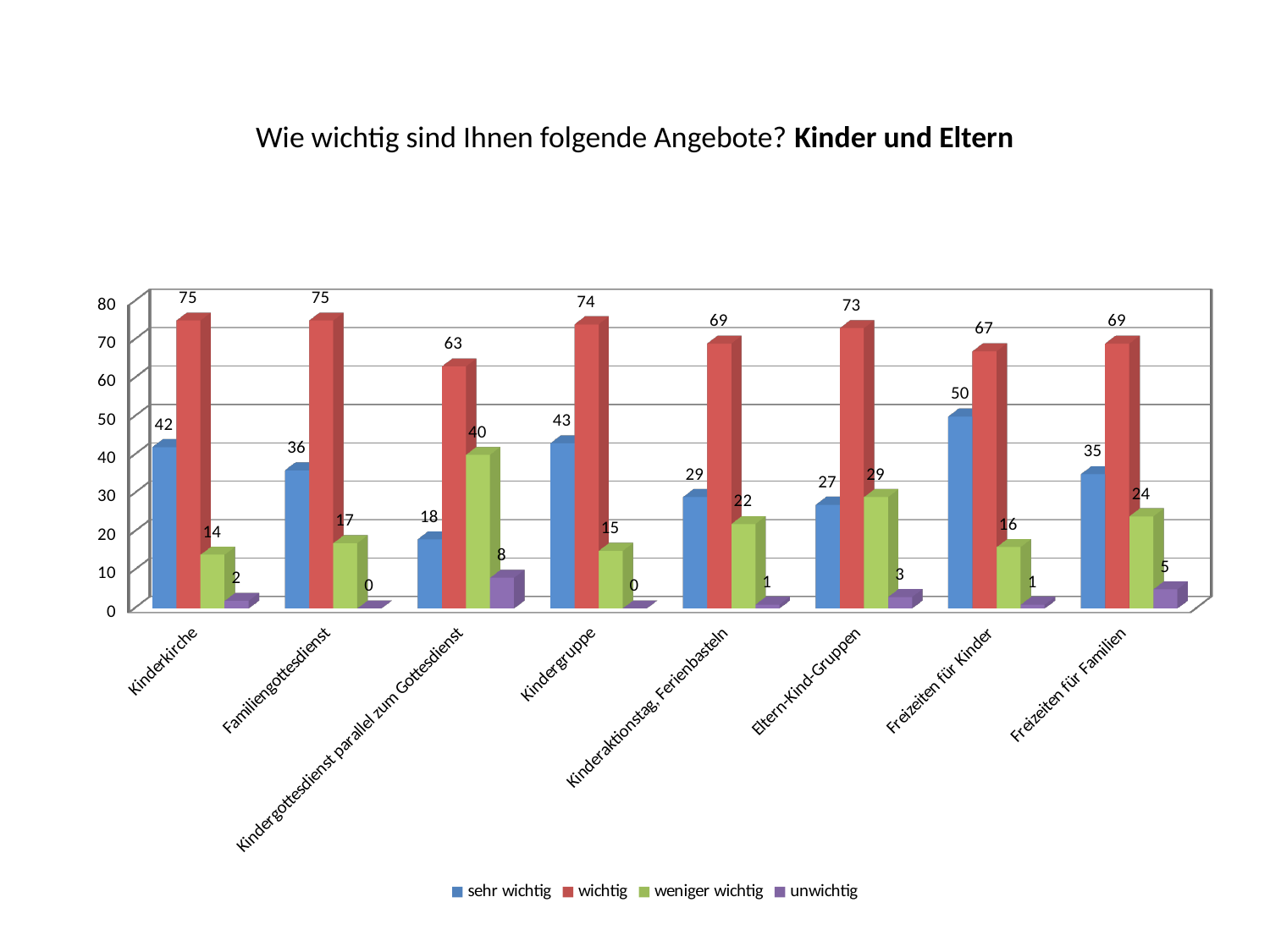
Which category has the highest value for "unwichtig"? Kindergottesdienst parallel zum Gottesdienst What is the value for "weniger wichtig" for Kindergottesdienst parallel zum Gottesdienst? 40 Which category has the lowest value for "wichtig"? Kindergottesdienst parallel zum Gottesdienst What is the value for "wichtig" for Eltern-Kind-Gruppen? 73 What is the value for "sehr wichtig" for Freizeiten für Kinder? 50 How many series does the legend list? 4 How many categories are shown on the x axis? 8 What is the difference between the "wichtig" and "sehr wichtig" values for Kinderkirche? 33 Which category has the highest value for "sehr wichtig"? Freizeiten für Kinder Which is larger: the "sehr wichtig" value for Kindergruppe or for Familiengottesdienst? Kindergruppe What kind of chart is shown on the slide? Bar chart What is the value for "unwichtig" for Freizeiten für Familien? 5